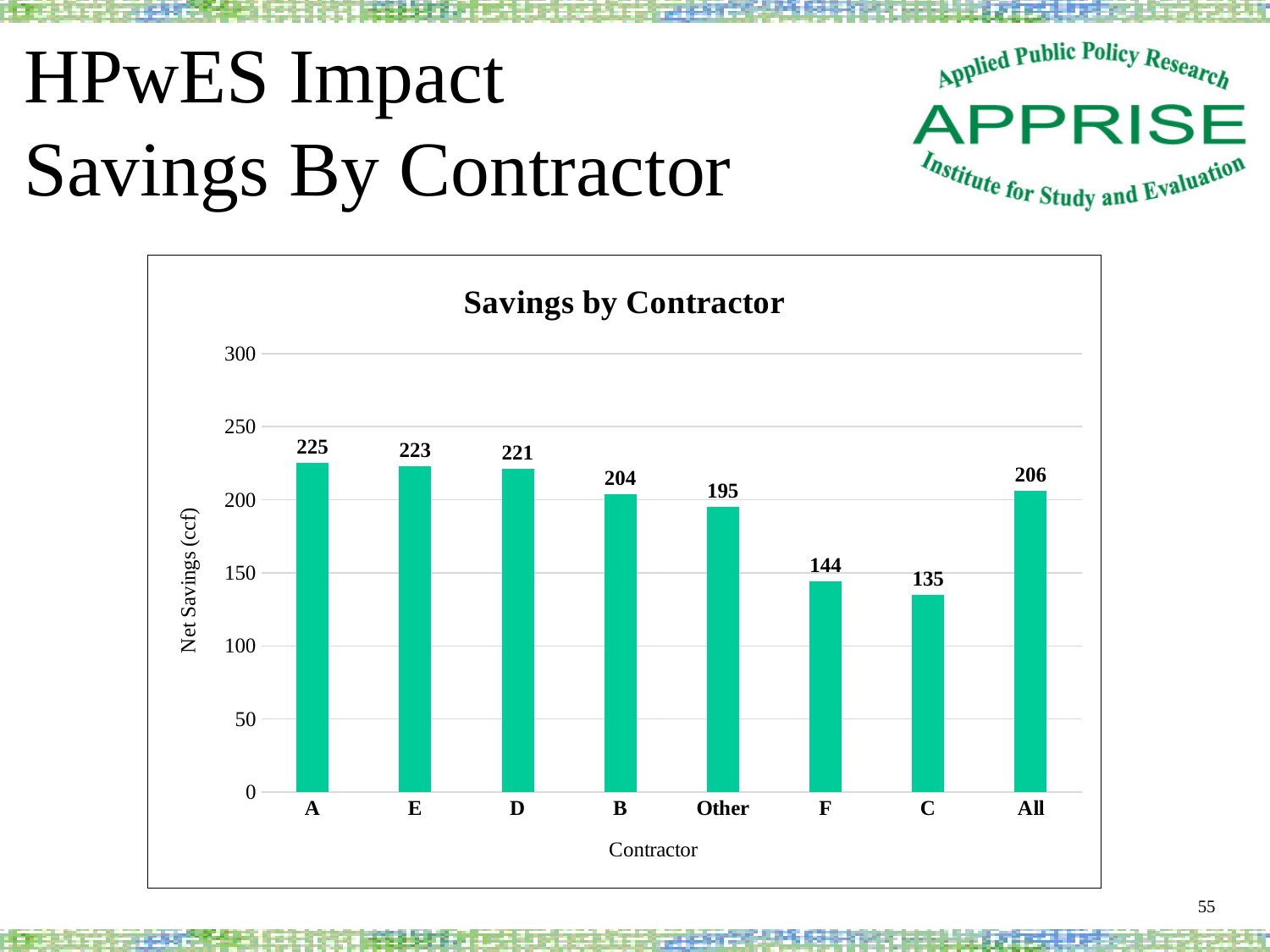
Which has higher net savings, contractor F or the 'Other' category? Other What is the title of the chart? Savings by Contractor What is the difference in net savings between contractor B and contractor F? 60 Which contractor has the lowest net savings? C What is the net savings value for the 'All' category? 206 What is the net savings value for contractor A? 225 What type of chart is shown on the slide? Bar chart Is the value for contractor F greater or less than 150? less What is the net savings value for contractor C? 135 How many categories are shown on the x axis of the chart? 8 What is the difference in net savings between contractor A and contractor C? 90 Which contractor has the highest net savings? A